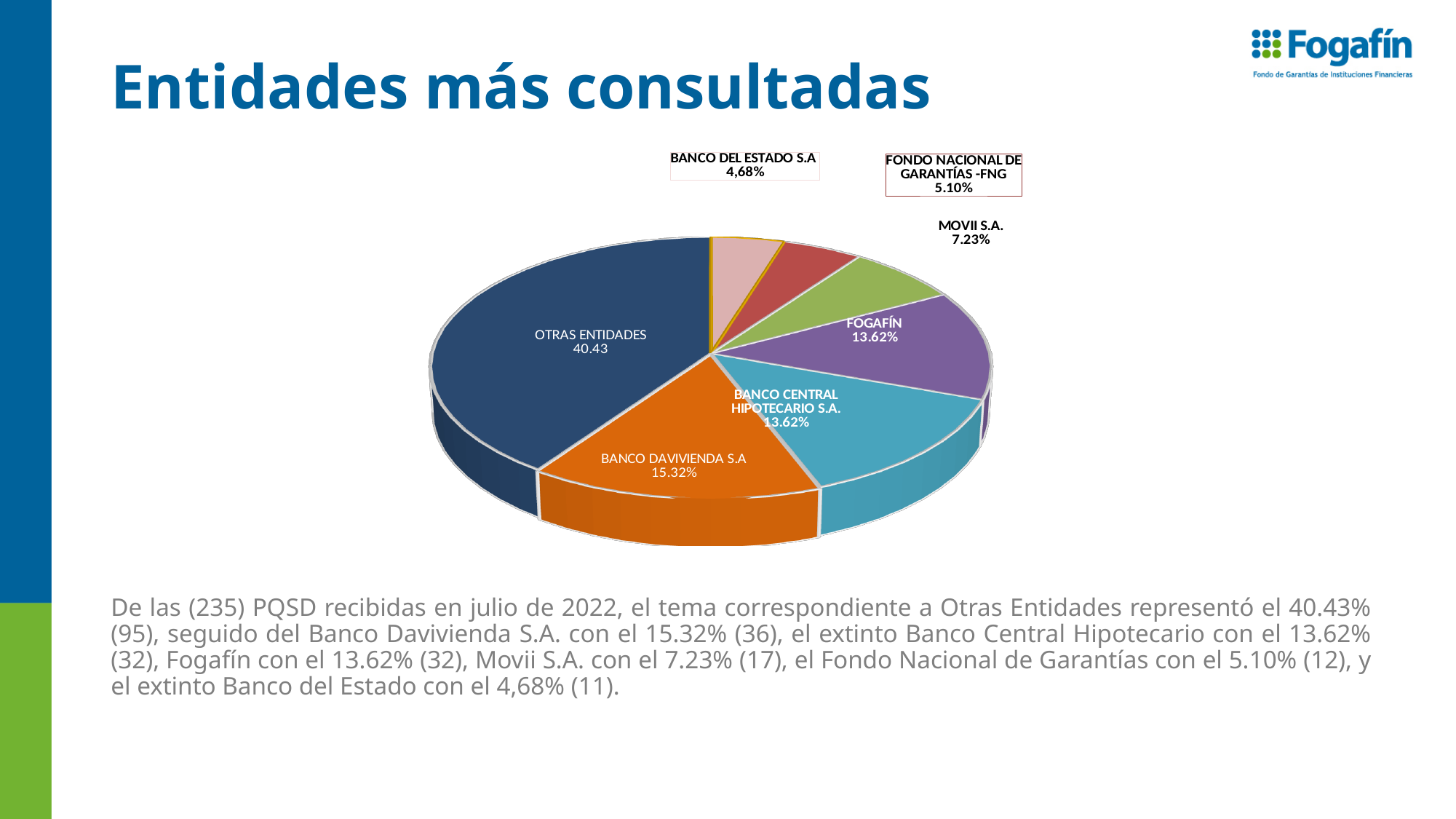
What is the value shown for BANCO DEL ESTADO S.A in the pie chart? 4,68% What kind of chart is shown on the slide? Pie chart What is the value shown for BANCO DAVIVIENDA S.A in the pie chart? 15.32% Which slice of the pie chart is the largest? OTRAS ENTIDADES How many slices does the pie chart have? 7 What is the value shown for MOVII S.A. in the pie chart? 7.23% Which is larger in the pie chart, BANCO DAVIVIENDA S.A or MOVII S.A.? BANCO DAVIVIENDA S.A Which slice of the pie chart is the smallest? BANCO DEL ESTADO S.A What is the value shown for OTRAS ENTIDADES in the pie chart? 40.43 What is the title of the slide containing the pie chart? Entidades más consultadas What is the difference between the values for BANCO DAVIVIENDA S.A and FOGAFÍN in the pie chart? 1.70% What is the value shown for FONDO NACIONAL DE GARANTÍAS -FNG in the pie chart? 5.10%